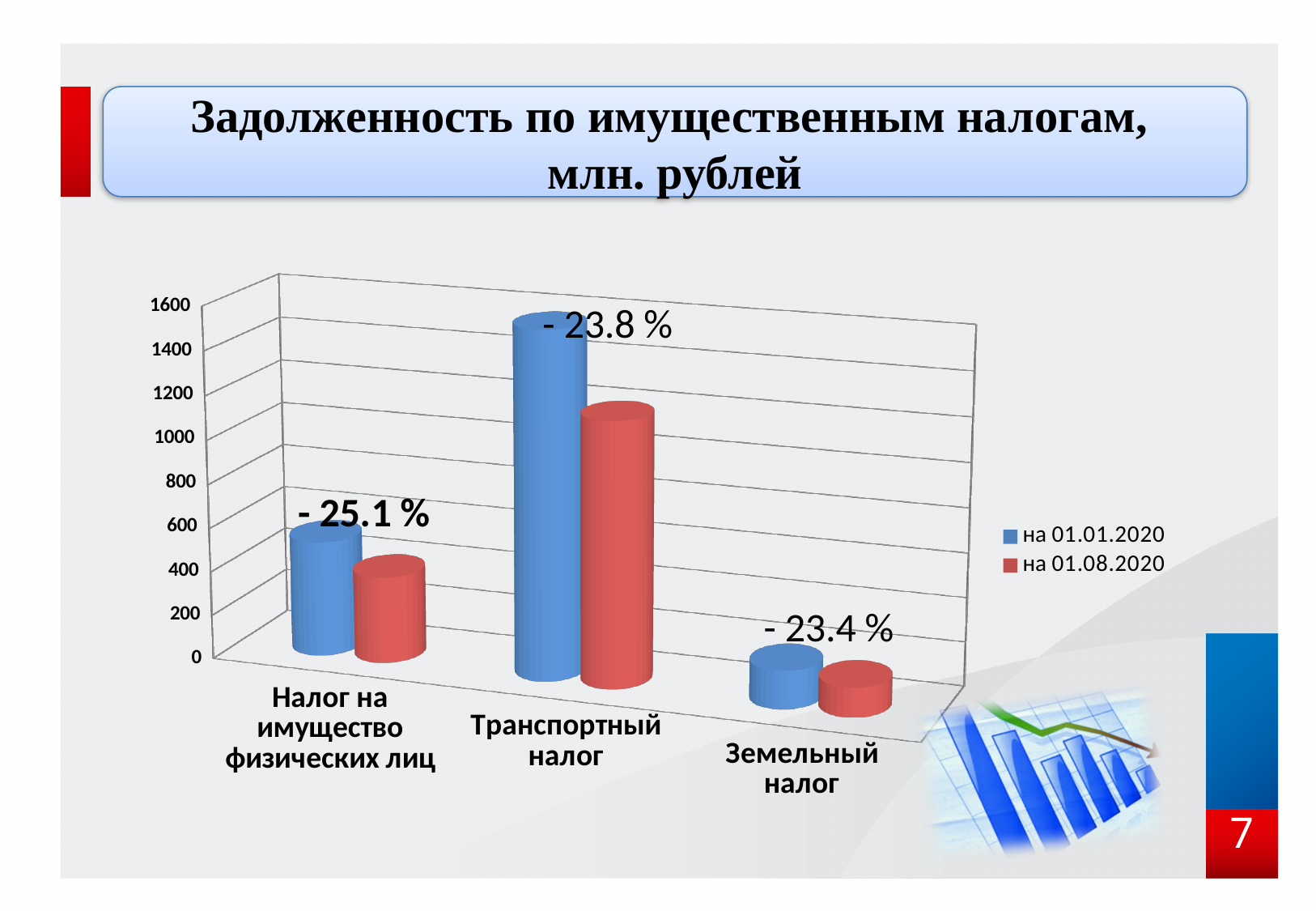
Which tax category has the lowest debt as of 01.08.2020? Земельный налог Is the value for Налог на имущество физических лиц as of 01.01.2020 greater or less than 800? less Is the value for Транспортный налог as of 01.01.2020 greater or less than 1000? greater For Транспортный налог, which is larger: the value as of 01.01.2020 or as of 01.08.2020? на 01.01.2020 What percentage change is printed above the bars for Налог на имущество физических лиц? - 25.1 % How many series does the chart legend list? 2 How many tax categories are shown on the x axis of the chart? 3 What kind of chart is shown on the slide? bar chart Which tax category has the highest debt as of 01.01.2020? Транспортный налог Is the value for Земельный налог as of 01.01.2020 greater or less than 400? less What percentage change is printed above the bars for Земельный налог? - 23.4 % What are the two series named in the chart legend? на 01.01.2020 and на 01.08.2020